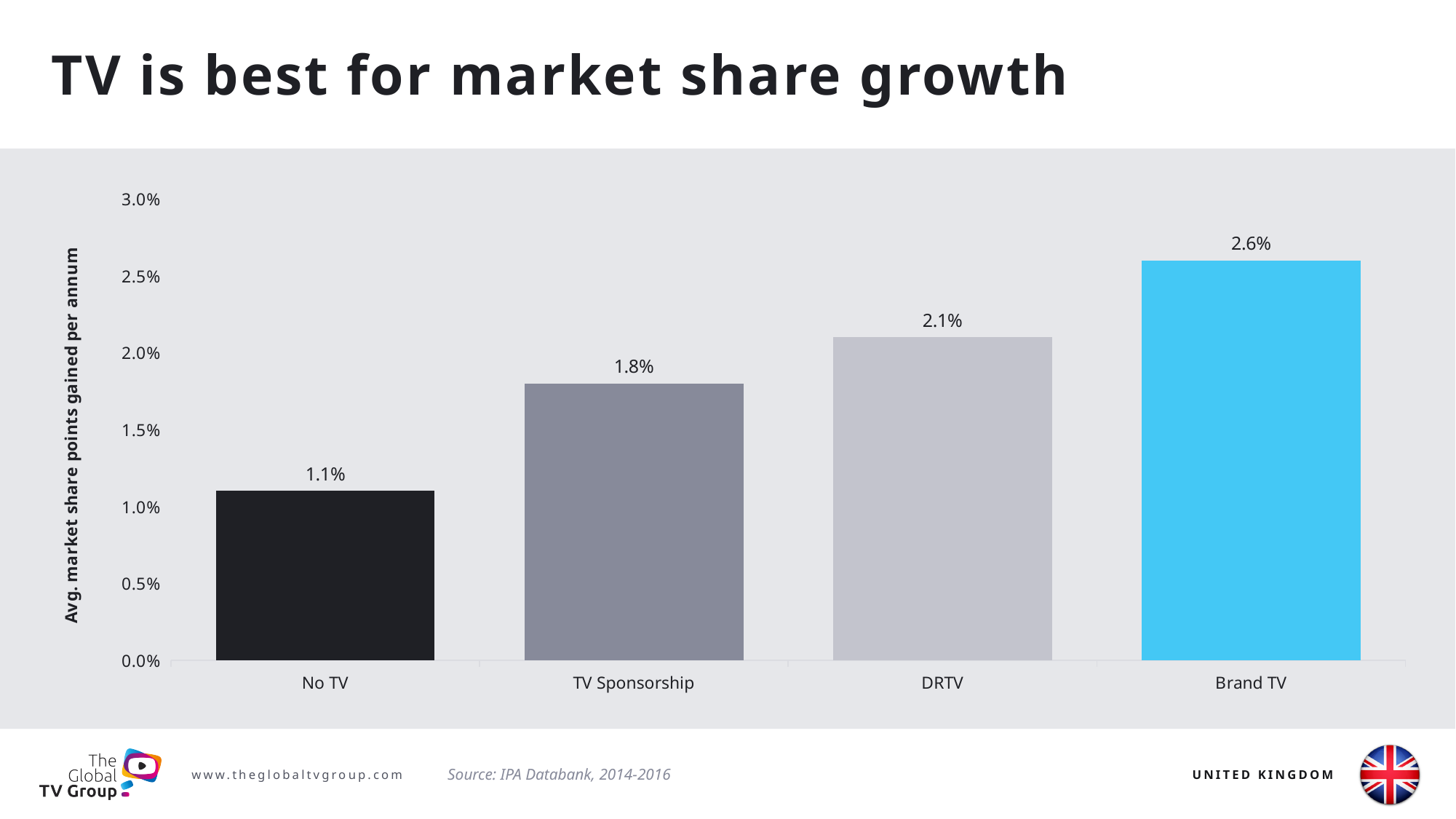
Which category has the lowest value? No TV What is the difference between the values for Brand TV and No TV? 1.5% What kind of chart is shown on the slide? bar chart What is the label of the vertical axis? Avg. market share points gained per annum How many categories are shown on the x axis? 4 What is the value for No TV? 1.1% What is the value for DRTV? 2.1% What is the value for Brand TV? 2.6% Which category has the highest value? Brand TV Which is larger, the value for DRTV or the value for TV Sponsorship? DRTV Is the value for TV Sponsorship greater or less than 2.0%? less What is the value for TV Sponsorship? 1.8%